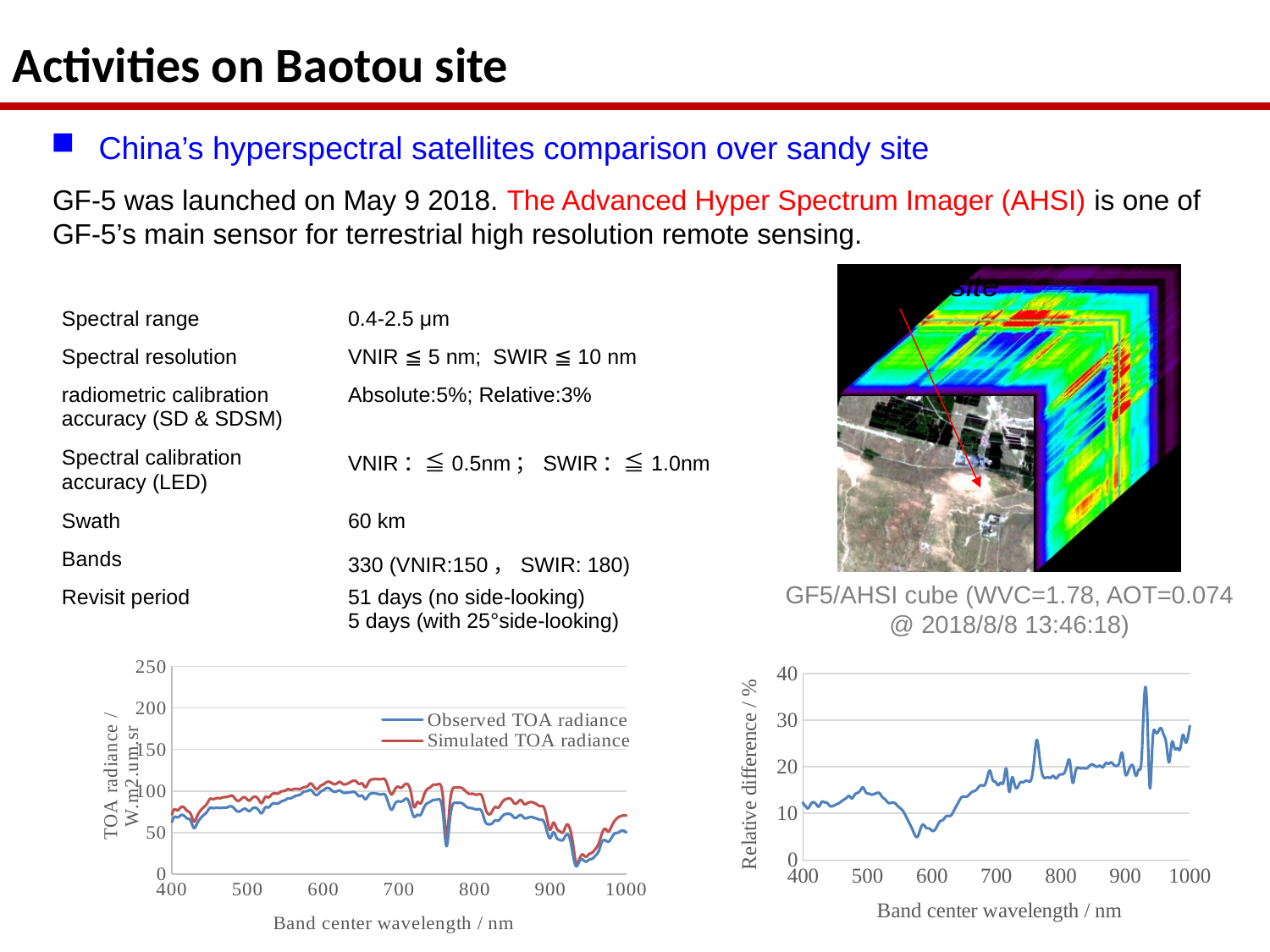
In the bottom-right chart, is the relative difference at 1000 nm greater or less than 20? greater In the bottom-right chart, is the relative difference at about 580 nm greater or less than 10? less In the bottom-left chart, is the Observed TOA radiance at 600 nm greater or less than 150? less What kind of chart is the chart on the bottom right of the slide? line chart What is the x-axis title of the bottom-right chart? Band center wavelength / nm How many series does the legend of the bottom-left chart list? 2 In the bottom-right chart, does the relative difference generally rise or fall between 600 nm and 1000 nm? rise What kind of chart is the chart on the bottom left of the slide? line chart In the bottom-left chart, which series is higher at 700 nm, Observed TOA radiance or Simulated TOA radiance? Simulated TOA radiance